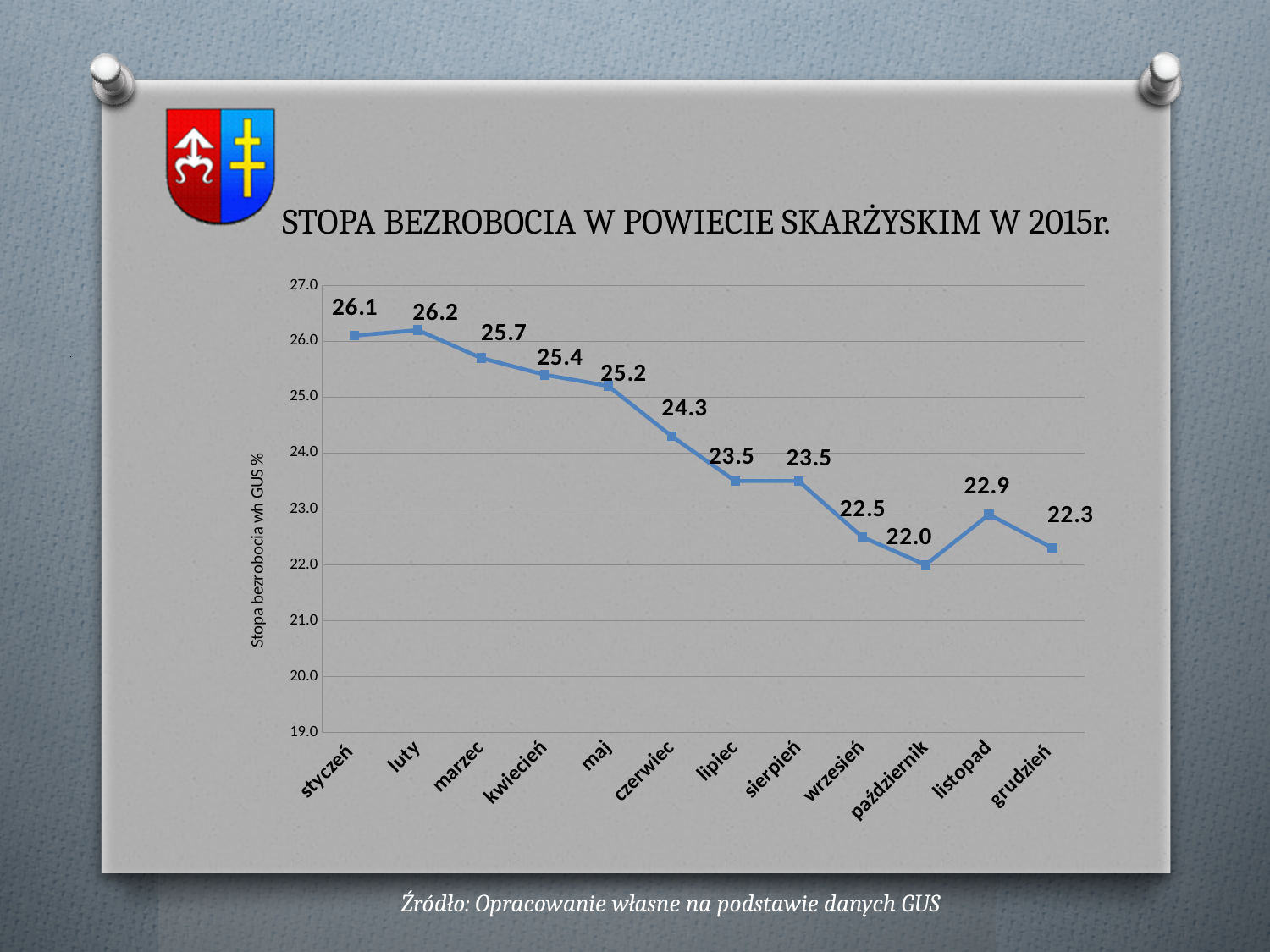
Which month has the highest unemployment rate? luty Does the unemployment rate generally rise or fall from styczeń to grudzień? fall What is the value for październik? 22.0 What is the unemployment rate for styczeń? 26.1 Is the value for wrzesień greater or less than 23.0? less What kind of chart is shown on the slide? line chart Which is larger, the value for marzec or the value for czerwiec? marzec What is the difference between the values for luty and grudzień? 3.9 What is the title of the chart? STOPA BEZROBOCIA W POWIECIE SKARŻYSKIM W 2015r. Which month has the lowest unemployment rate? październik What is the value for listopad? 22.9 How many months are plotted on the chart? 12